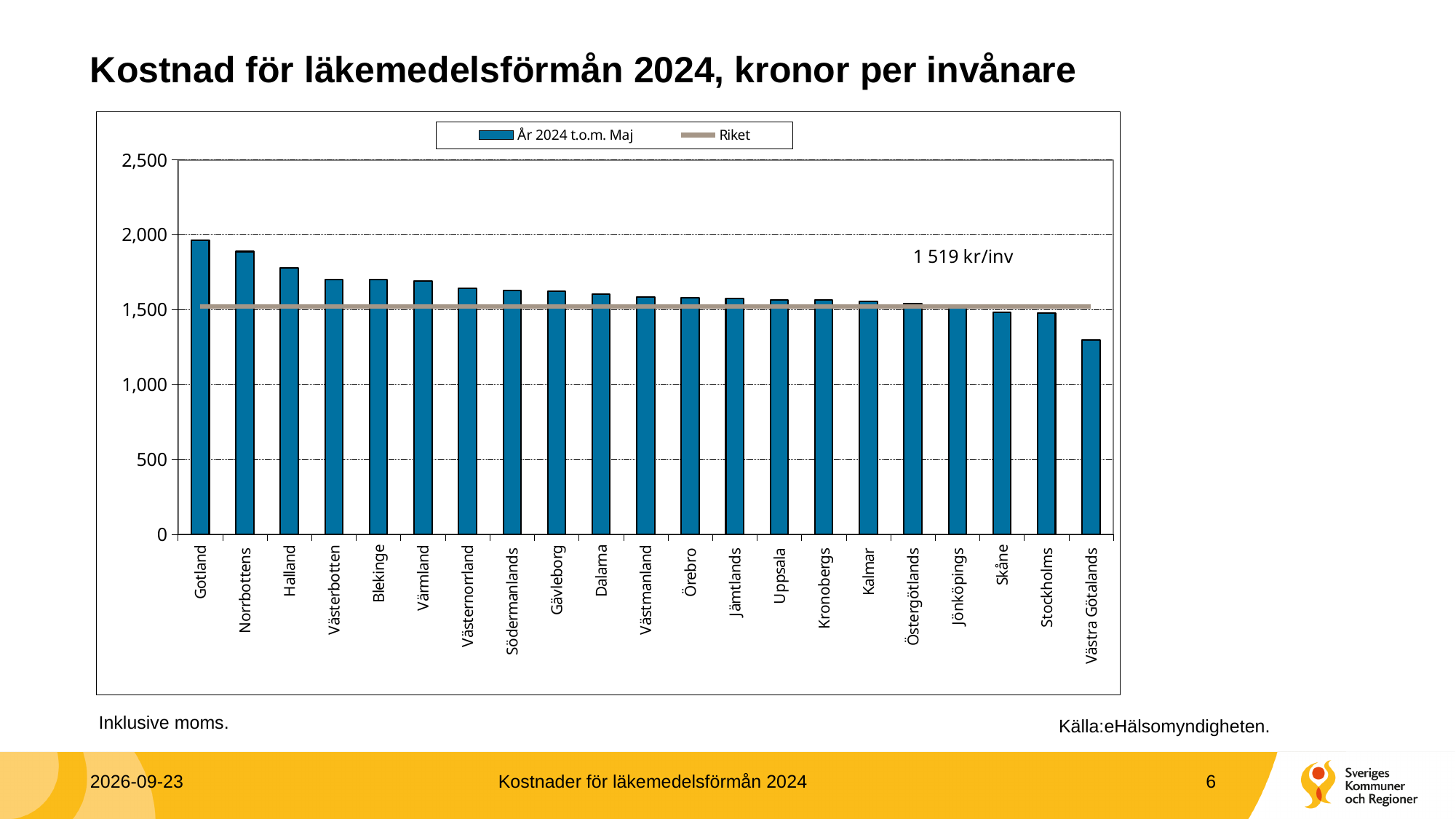
What kind of chart is shown on the slide? Bar chart Is the value for Gotland greater or less than 2,000? less What is the title of the chart? Kostnad för läkemedelsförmån 2024, kronor per invånare Which region has the lowest cost per inhabitant? Västra Götalands What value is printed for Riket (the national level)? 1 519 kr/inv How many regions (categories) are shown on the x axis? 21 How many series does the legend list? 2 Is the value for Västra Götalands greater or less than 1,500? less Do the bar values rise or fall from left to right along the x axis? Fall Is the value for Halland greater or less than 1,500? greater Which is larger, the value for Gotland or the value for Norrbottens? Gotland Which region has the highest cost per inhabitant? Gotland